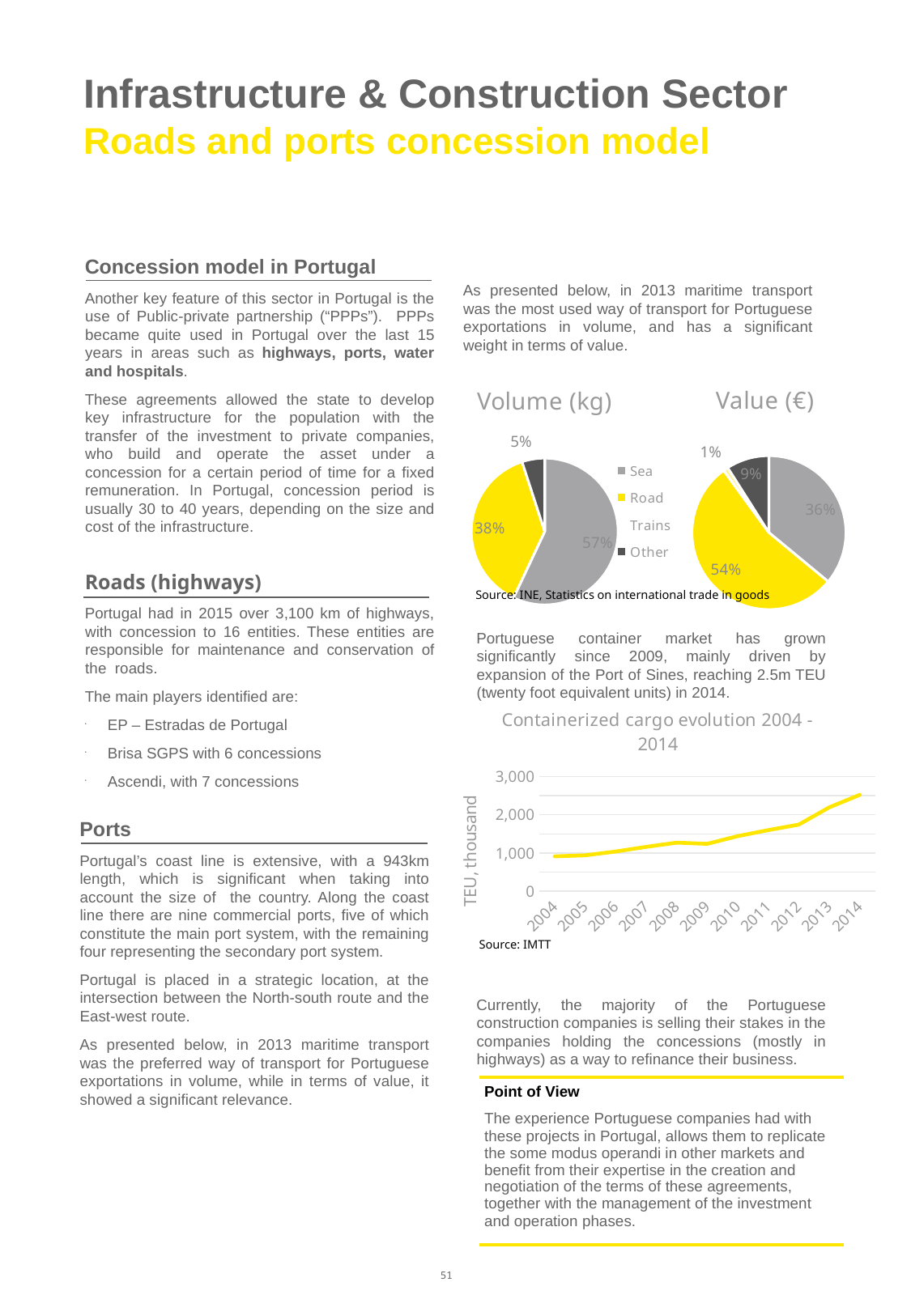
How many entries does the legend of the Volume (kg) pie chart list? 4 What kind of chart is 'Containerized cargo evolution 2004 - 2014'? Line chart In the Volume (kg) pie chart, which mode of transport has the largest share? Sea In the Value (€) pie chart, what share does Sea account for? 36% In the Value (€) pie chart, what share does Road account for? 54% In the Volume (kg) pie chart, what is the difference in percentage points between the Sea share and the Road share? 19 percentage points In the Volume (kg) pie chart, what share does Sea account for? 57% In the Volume (kg) pie chart, what share does Road account for? 38% How many years are shown on the x axis of the 'Containerized cargo evolution 2004 - 2014' chart? 11 In the 'Containerized cargo evolution 2004 - 2014' chart, do the values generally rise or fall from 2004 to 2014? Rise In the Value (€) pie chart, which mode of transport has the largest share? Road In the 'Containerized cargo evolution 2004 - 2014' chart, is the value for 2014 greater or less than 2,000? greater